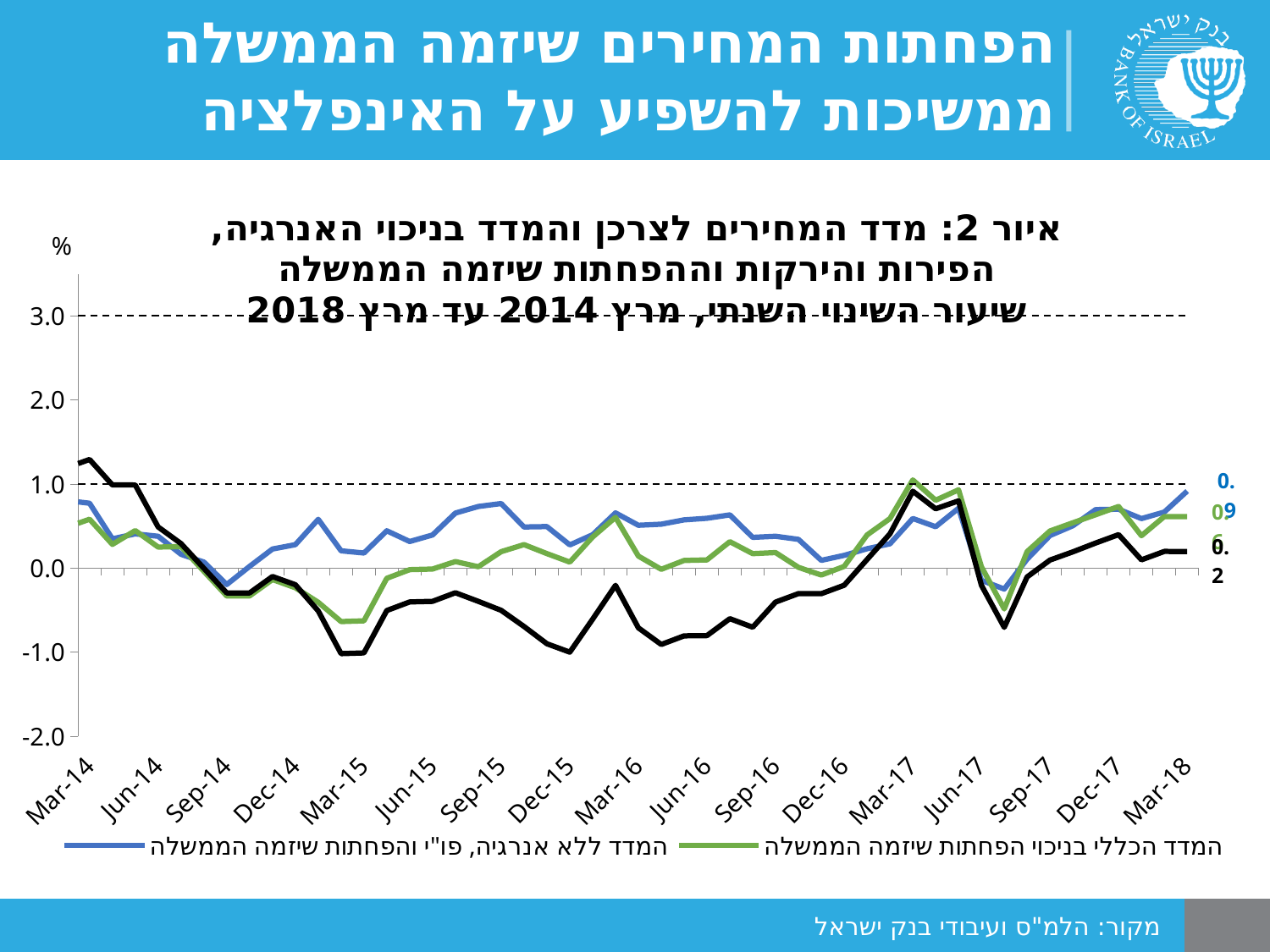
Is the value of the blue line at Mar-18 greater or less than 0.5? greater Does the black line rise or fall between Mar-14 and Mar-15? fall Is the value of the black line at Mar-15 greater or less than -0.5? less At Mar-15, which line is higher, the blue line or the black line? the blue line Is the value of the green line at Mar-17 greater or less than 0.5? greater What kind of chart is shown on the slide? line chart What unit is shown at the top of the y axis? % What is the highest tick value shown on the y axis? 3.0 How many date labels are shown on the x axis? 17 How many lines are plotted on the chart? 3 What is the first and last label on the x axis? Mar-14 and Mar-18